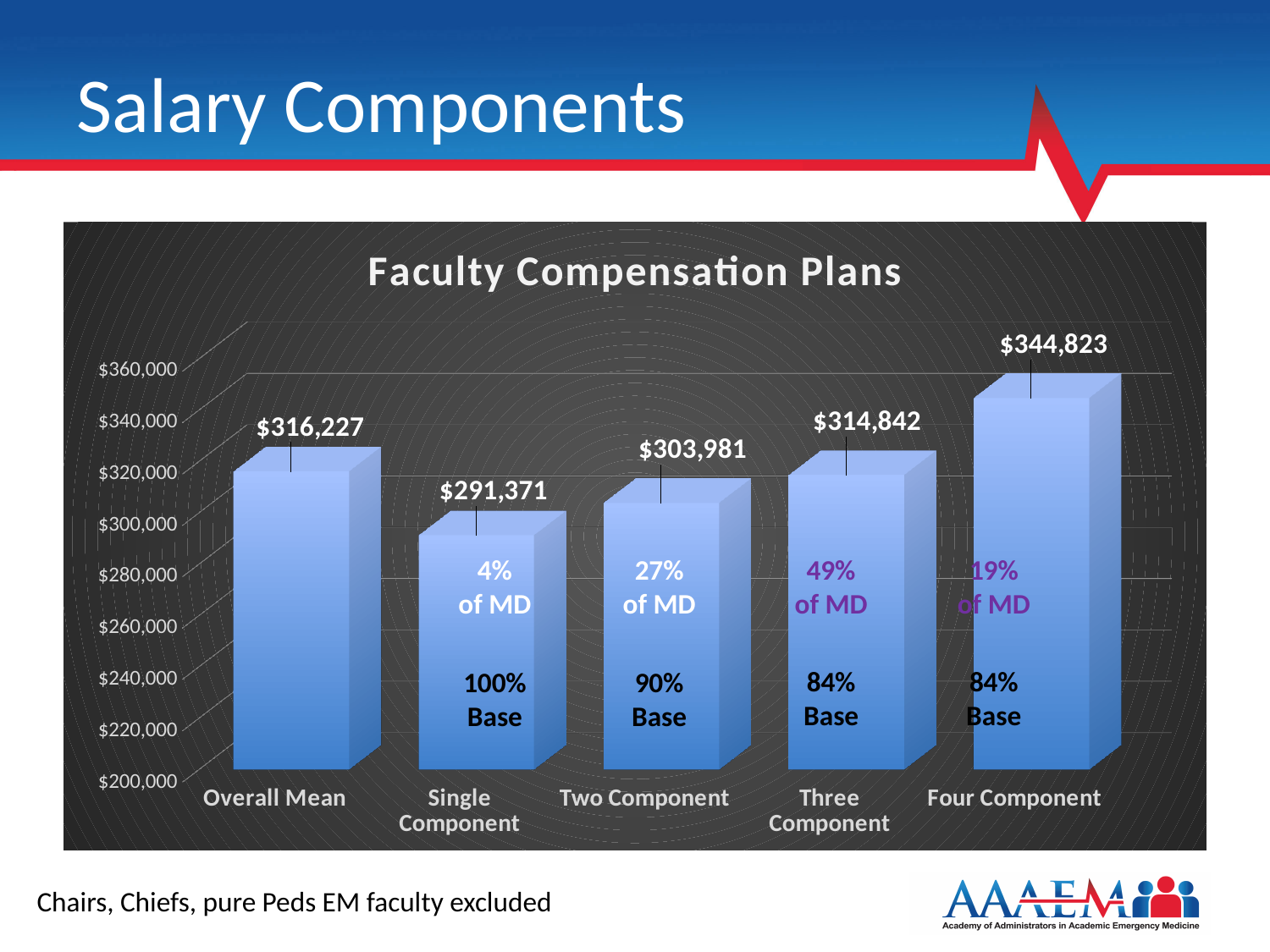
What is the difference between the Four Component and Single Component values? $53,452 What is the value for Single Component? $291,371 Is the value for Two Component greater or less than $300,000? greater What is the value for Two Component? $303,981 What is the value for Overall Mean? $316,227 What kind of chart is this? bar chart Which category has the lowest value? Single Component Which category has the highest value? Four Component What is the value for Four Component? $344,823 Which is larger, the value for Three Component or the value for Overall Mean? Overall Mean What is the title of the chart? Faculty Compensation Plans How many categories are shown on the x axis? 5